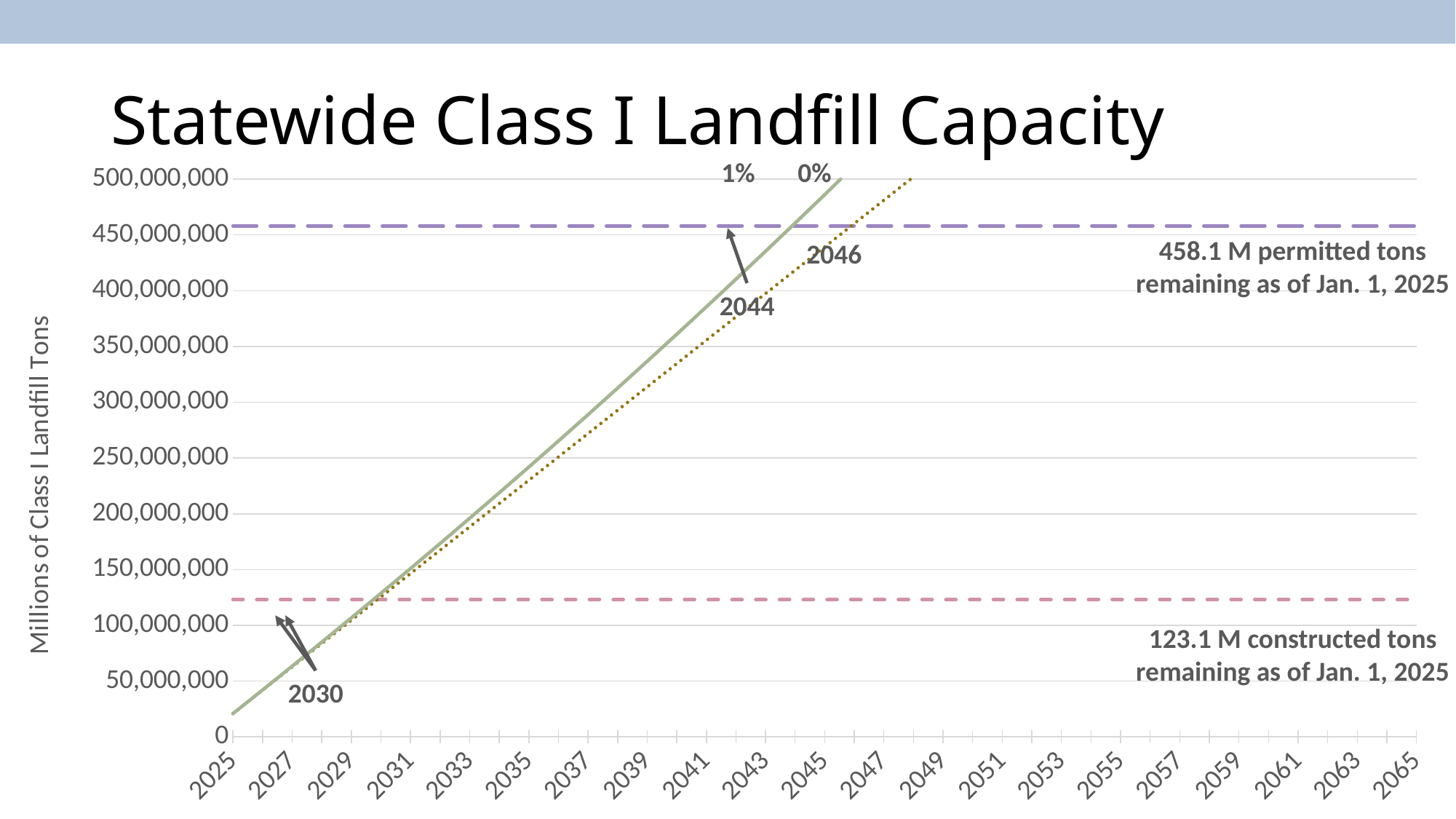
Is the permitted tons remaining line greater or less than 450,000,000 on the vertical axis? greater How many constructed tons were remaining as of Jan. 1, 2025, according to the chart annotation? 123.1 M Do the projection lines rise or fall as the years increase along the x axis? rise Which growth scenario reaches the permitted capacity sooner, 1% or 0%? 1% How many permitted tons were remaining as of Jan. 1, 2025, according to the chart annotation? 458.1 M What is the label on the vertical axis of the chart? Millions of Class I Landfill Tons In which year does the 0% growth line reach the permitted capacity, according to the chart annotation? 2046 In which year do the projection lines reach the constructed capacity, according to the chart annotation? 2030 What kind of chart is shown on the slide? line chart In which year does the 1% growth line reach the permitted capacity, according to the chart annotation? 2044 What is the difference between the permitted tons remaining and the constructed tons remaining as of Jan. 1, 2025? 335.0 M What is the title of the chart? Statewide Class I Landfill Capacity